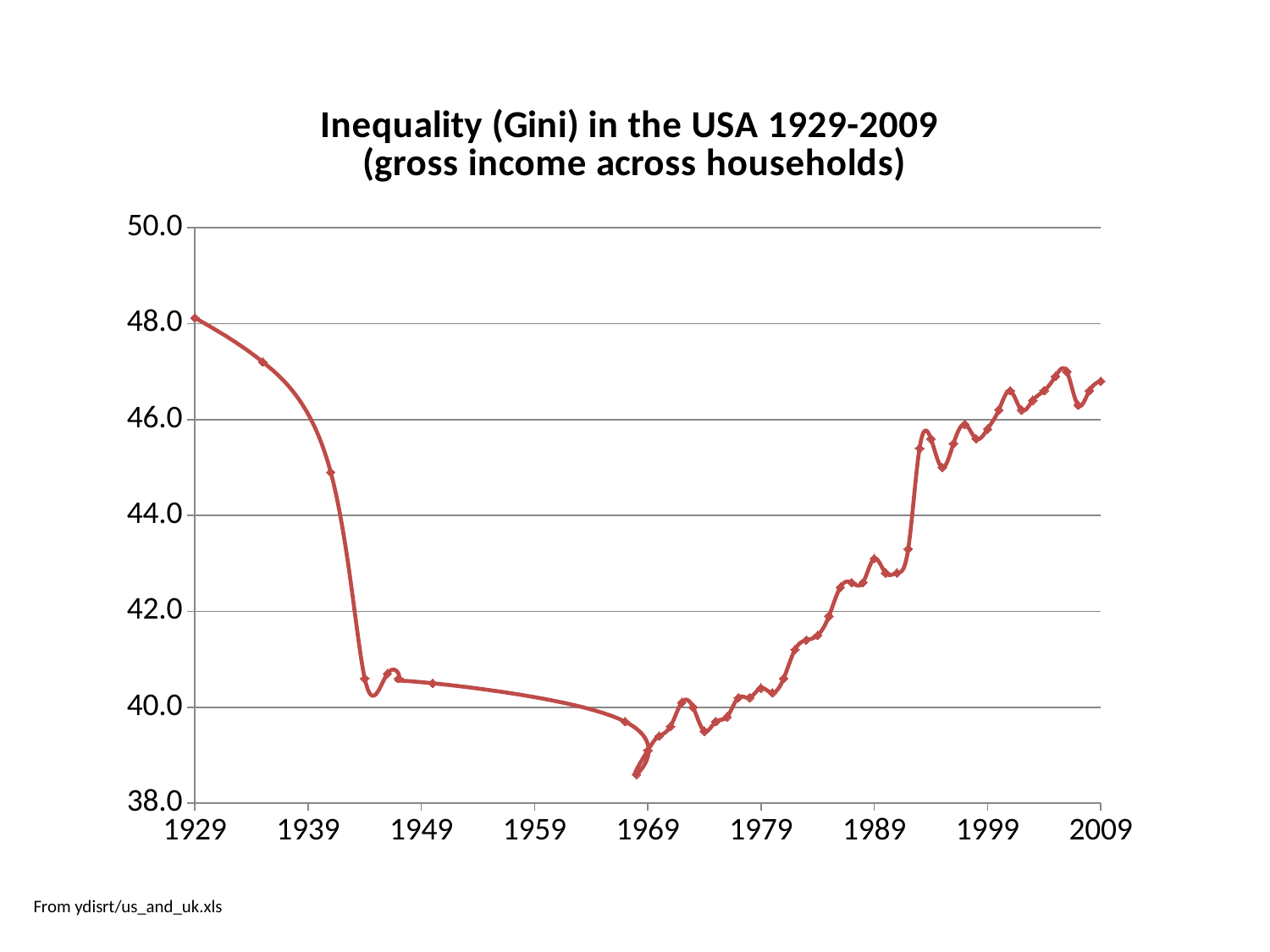
Is the value for 1989 greater or less than 42.0? greater Is the value for 1949 greater or less than 42.0? less Is the value for 1979 greater or less than 42.0? less Does the line rise or fall between 1969 and 2009? rise What kind of chart is shown on the slide? line chart Does the line rise or fall between 1929 and 1969? fall Which year has the higher value, 1929 or 2009? 1929 Which year has the higher value, 1949 or 1989? 1989 What is the title of the chart? Inequality (Gini) in the USA 1929-2009 (gross income across households)